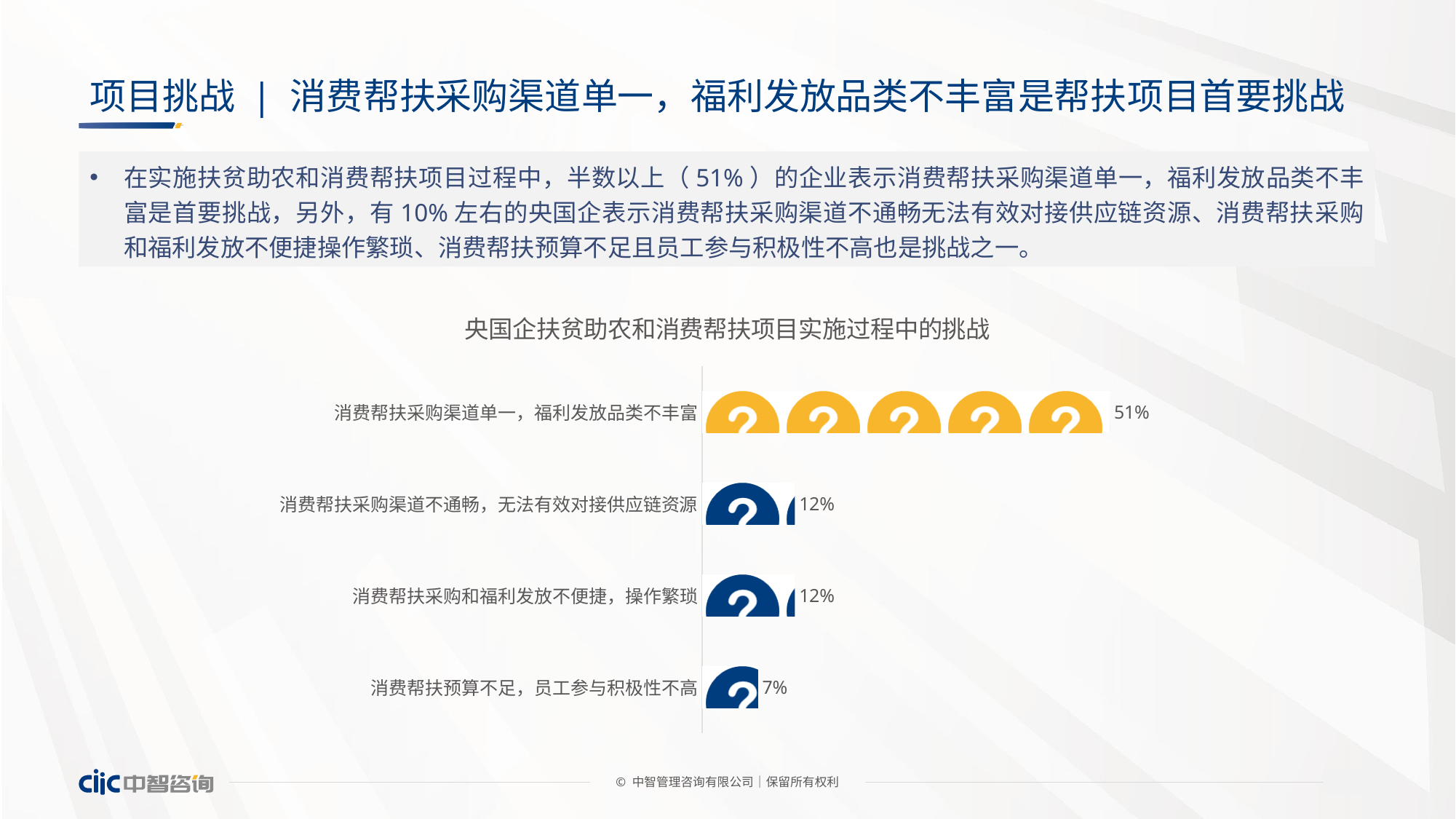
What is the value for 消费帮扶采购渠道不通畅，无法有效对接供应链资源? 12% What is the value for 消费帮扶预算不足，员工参与积极性不高? 7% What is the value for 消费帮扶采购渠道单一，福利发放品类不丰富? 51% Which category has the lowest value? 消费帮扶预算不足，员工参与积极性不高 Which category has the highest value? 消费帮扶采购渠道单一，福利发放品类不丰富 What is the value for 消费帮扶采购和福利发放不便捷，操作繁琐? 12% How many categories are shown in the chart? 4 What is the difference between the value for 消费帮扶采购渠道单一，福利发放品类不丰富 and the value for 消费帮扶预算不足，员工参与积极性不高? 44% What kind of chart is shown on the slide? Bar chart What is the title of the chart? 央国企扶贫助农和消费帮扶项目实施过程中的挑战 What is the difference between the value for 消费帮扶采购渠道不通畅，无法有效对接供应链资源 and the value for 消费帮扶预算不足，员工参与积极性不高? 5% Which is larger: the value for 消费帮扶采购和福利发放不便捷，操作繁琐 or the value for 消费帮扶预算不足，员工参与积极性不高? 消费帮扶采购和福利发放不便捷，操作繁琐